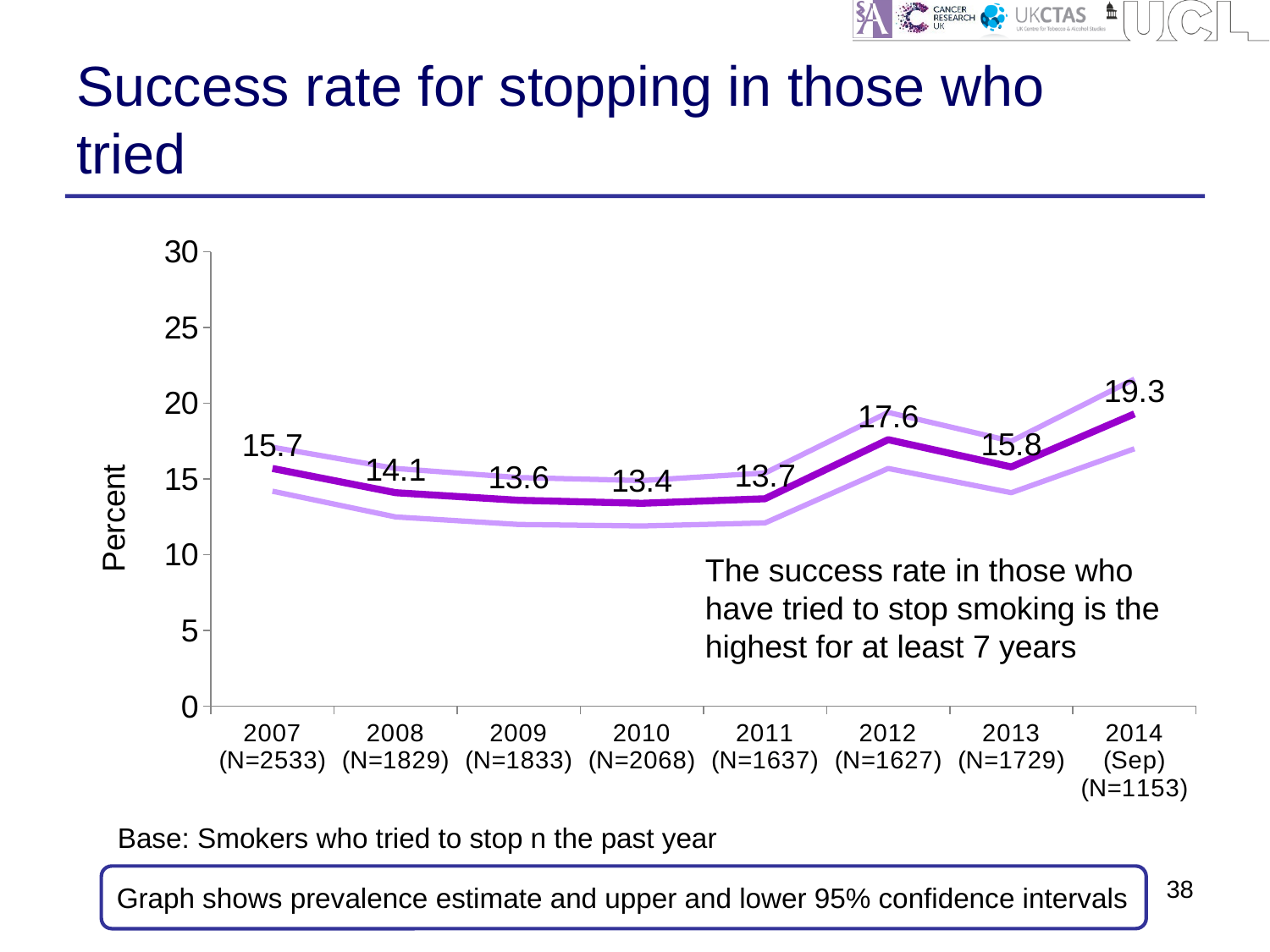
Which year has the lowest success rate? 2010 What is the success rate for 2007? 15.7 Which year has the highest success rate? 2014 (Sep) What is the difference between the success rate in 2012 and in 2011? 3.9 Which is larger, the success rate in 2008 or in 2013? 2013 What is the difference between the success rate in 2014 (Sep) and in 2013? 3.5 What is the success rate for 2010? 13.4 What is the success rate for 2012? 17.6 Is the success rate for 2009 greater or less than 15? less What is the success rate for 2014 (Sep)? 19.3 What kind of chart is shown on the slide? line chart How many years are plotted on the x axis? 8